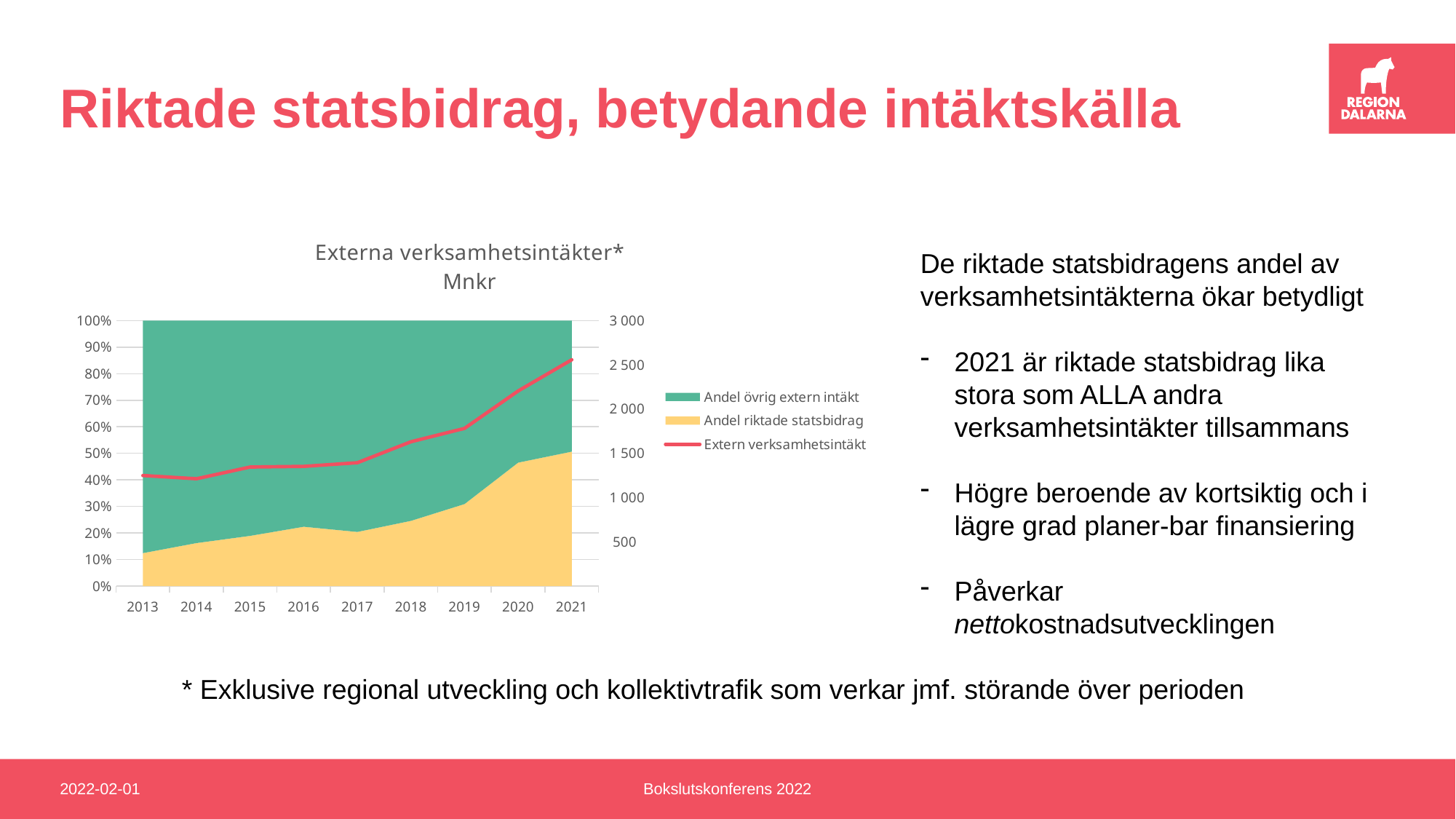
Is the value of Andel riktade statsbidrag in 2020 greater or less than 40%? greater Which series is shown in yellow in the chart? Andel riktade statsbidrag Is the value of Andel riktade statsbidrag in 2013 greater or less than 20%? less In which year is Andel riktade statsbidrag lowest? 2013 What kind of chart is shown on the slide? Stacked area chart with a line How many series does the chart legend list? 3 What is the title of the chart? Externa verksamhetsintäkter* Mnkr How many years are shown on the x axis of the chart? 9 Is the value of Extern verksamhetsintäkt in 2021 greater or less than 2 000? greater In which year is Extern verksamhetsintäkt highest? 2021 Does Extern verksamhetsintäkt rise or fall from 2013 to 2021? rise